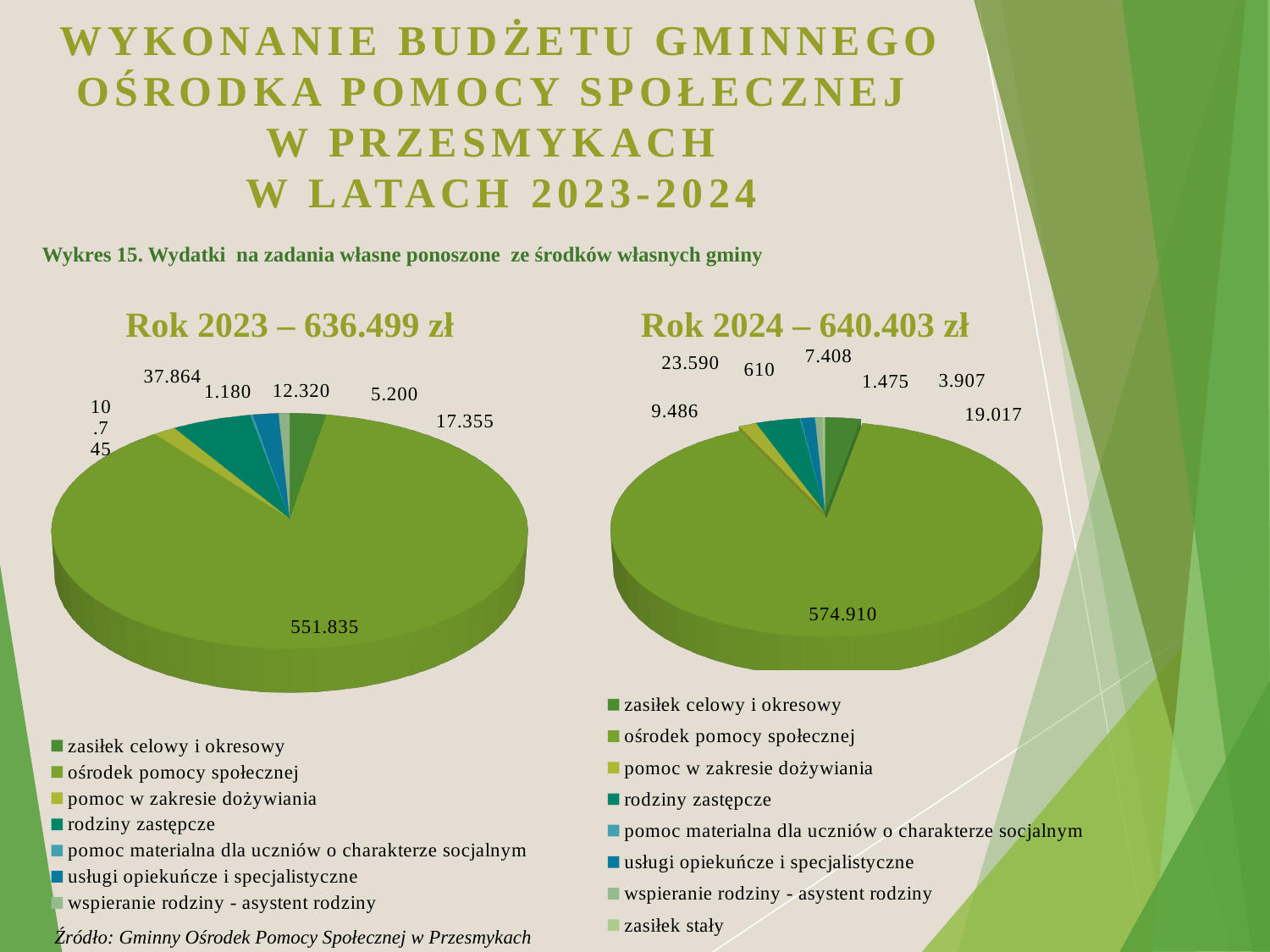
What is the difference between the largest slice in the 'Rok 2024 – 640.403 zł' chart (574.910) and the largest slice in the 'Rok 2023 – 636.499 zł' chart (551.835)? 23.075 What type of chart is used for the 'Rok 2023 – 636.499 zł' chart? pie chart In the 'Rok 2023 – 636.499 zł' chart, what is the smallest value shown on a slice? 1.180 In the 'Rok 2024 – 640.403 zł' chart, what is the value of the largest slice? 574.910 In the 'Rok 2023 – 636.499 zł' chart, what is the value of the largest slice? 551.835 According to the chart titles, what is the total for Rok 2024? 640.403 zł In the 'Rok 2024 – 640.403 zł' chart, what is the smallest value shown on a slice? 610 In the 'Rok 2023 – 636.499 zł' chart, how many categories does the legend list? 7 In the 'Rok 2024 – 640.403 zł' chart, how many categories does the legend list? 8 In the 'Rok 2023 – 636.499 zł' chart, which category has the largest slice? ośrodek pomocy społecznej Is the largest slice bigger in the 'Rok 2023 – 636.499 zł' chart or in the 'Rok 2024 – 640.403 zł' chart? Rok 2024 – 640.403 zł Which legend category appears in the 'Rok 2024 – 640.403 zł' chart but not in the 'Rok 2023 – 636.499 zł' chart? zasiłek stały